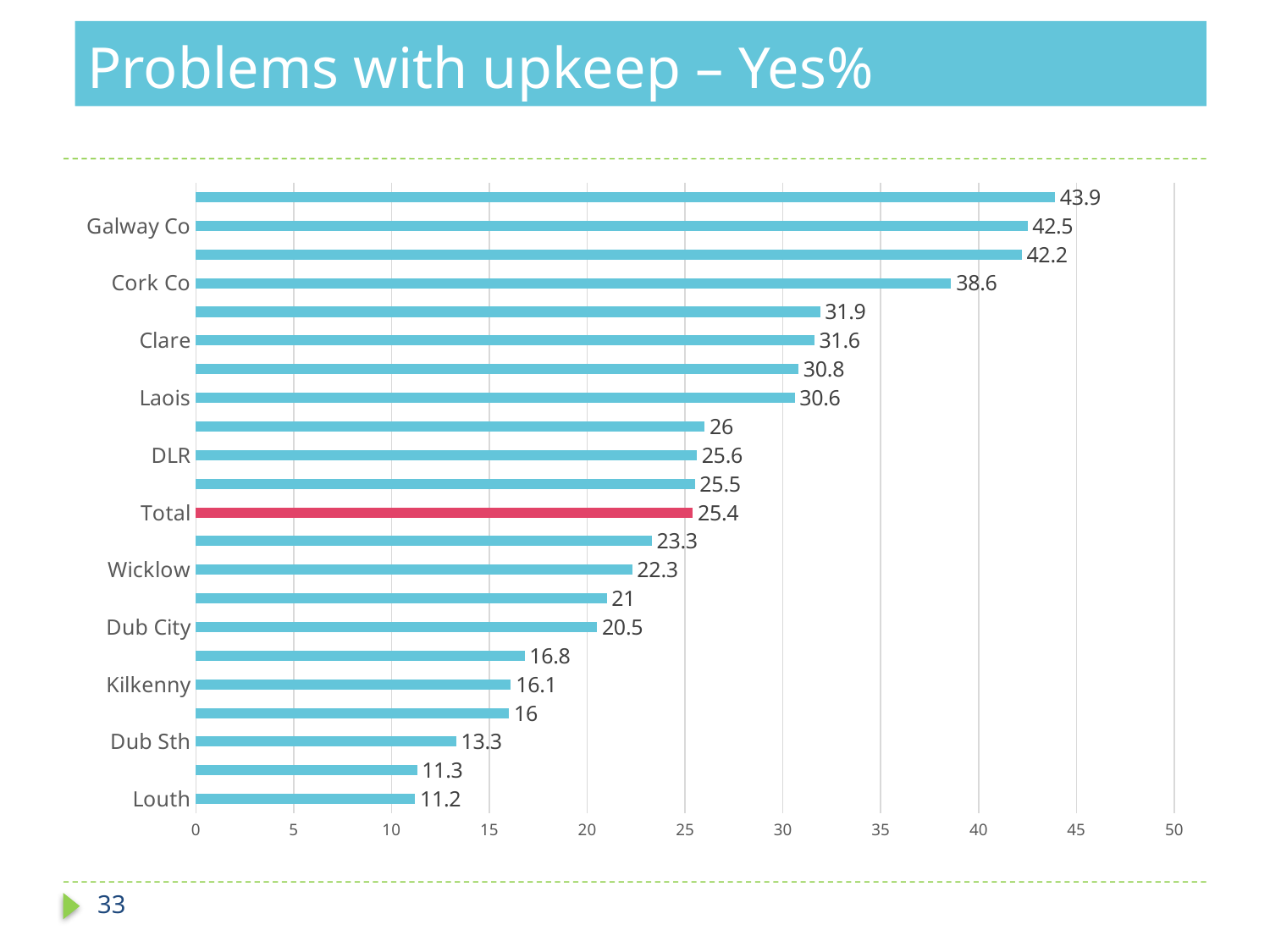
What is the difference between the values for Galway Co and Cork Co? 3.9 Which bar is shown in a different colour (red) from the others? Total What is the value for Total? 25.4 What is the value for Galway Co? 42.5 What kind of chart is shown on the slide? Bar chart Is the value for Wicklow greater or less than 25? less Which category has the lowest value? Louth What is the value for Kilkenny? 16.1 How many bars are plotted in the chart? 22 What is the value for Cork Co? 38.6 Which is larger, the value for Clare or the value for Laois? Clare What is the value for Louth? 11.2